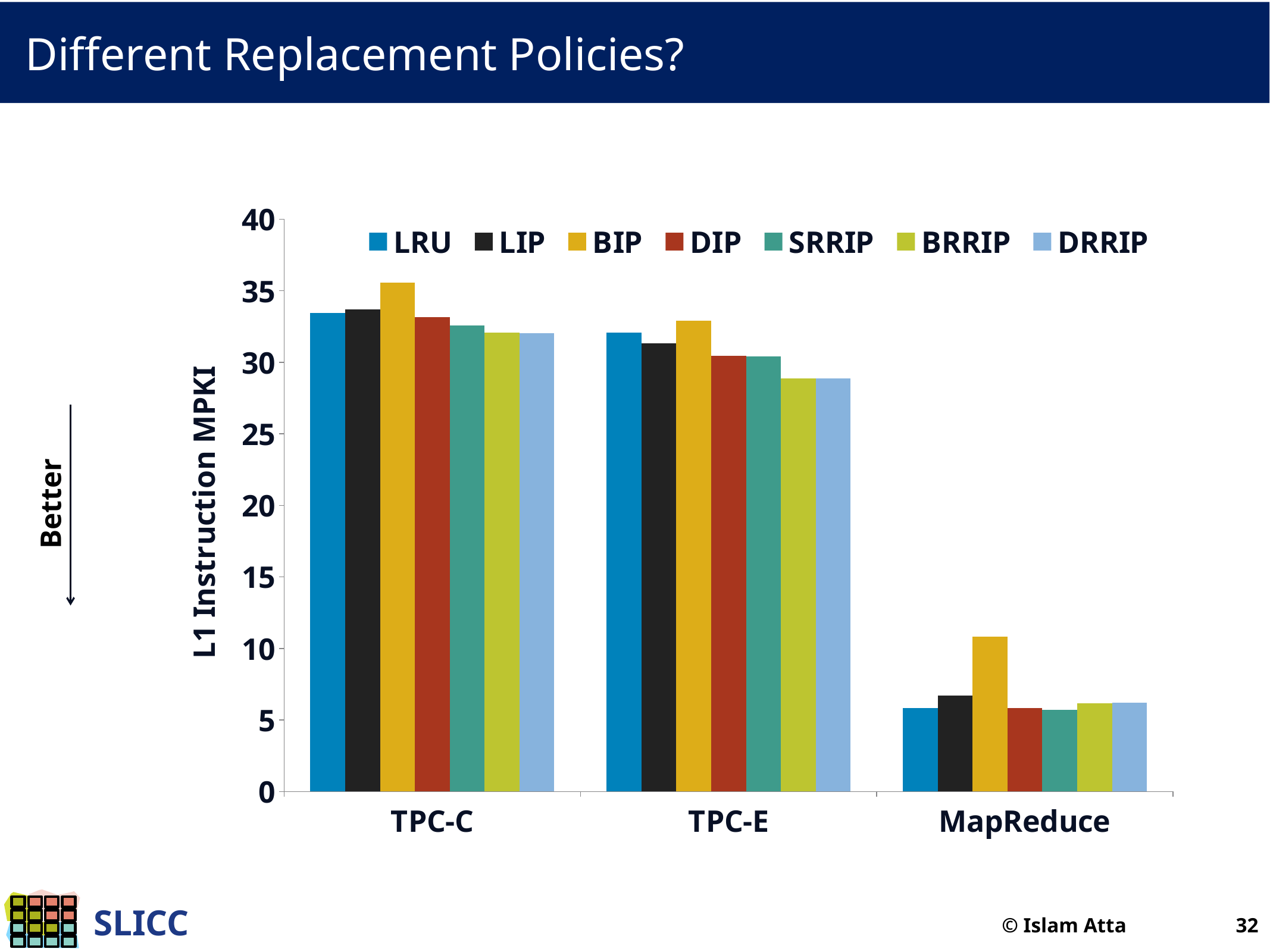
What is the label of the y axis? L1 Instruction MPKI Which replacement policy has the highest L1 Instruction MPKI for MapReduce? BIP For MapReduce, which is larger: the BIP value or the LRU value? BIP Is the BRRIP value for TPC-E greater or less than 30? less What kind of chart is shown on the slide? bar chart Which replacement policy has the highest L1 Instruction MPKI for TPC-C? BIP Which is larger: the LRU value for TPC-C or the LRU value for MapReduce? TPC-C Is the LRU value for TPC-C greater or less than 30? greater How many series does the legend list? 7 How many workload categories are shown on the x axis? 3 Is the BIP value for MapReduce greater or less than 10? greater Which replacement policy has the highest L1 Instruction MPKI for TPC-E? BIP